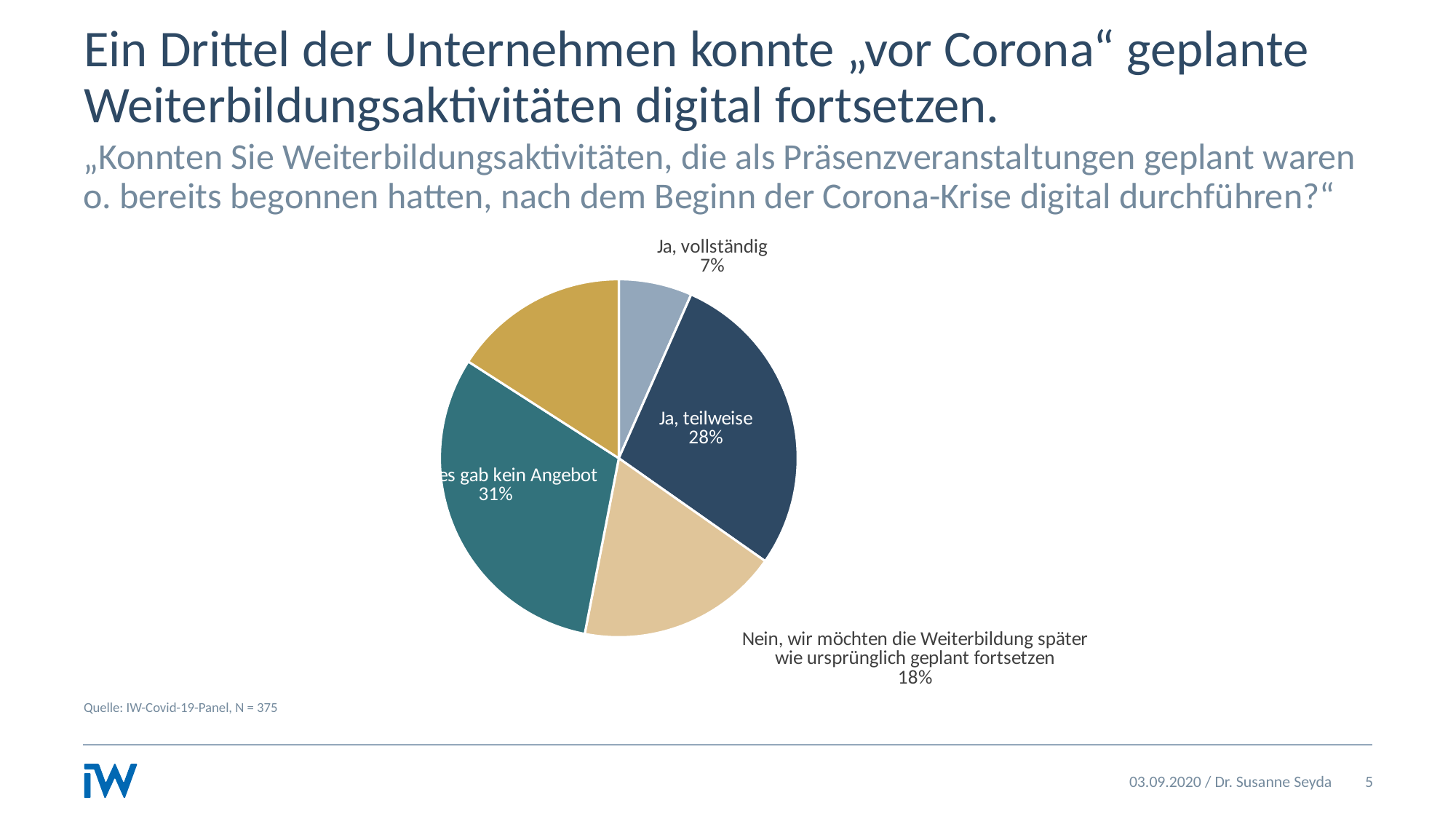
What is the difference in percentage points between "Ja, teilweise" and "Ja, vollständig"? 21 percentage points What percentage is shown for "Ja, vollständig"? 7% Which answer category has the largest share of the pie? es gab kein Angebot What is the sample size (N) given in the source note below the chart? N = 375 How many percentage points larger is "es gab kein Angebot" than "Ja, teilweise"? 3 percentage points How many slices does the pie chart have? 5 Which is larger: the share for "Ja, teilweise" or the share for "Nein, wir möchten die Weiterbildung später wie ursprünglich geplant fortsetzen"? Ja, teilweise What percentage of companies answered "Ja, teilweise"? 28% What percentage is shown for "es gab kein Angebot"? 31% Which answer category has the smallest share of the pie? Ja, vollständig What percentage of companies answered "Nein, wir möchten die Weiterbildung später wie ursprünglich geplant fortsetzen"? 18% What kind of chart is shown on the slide? pie chart